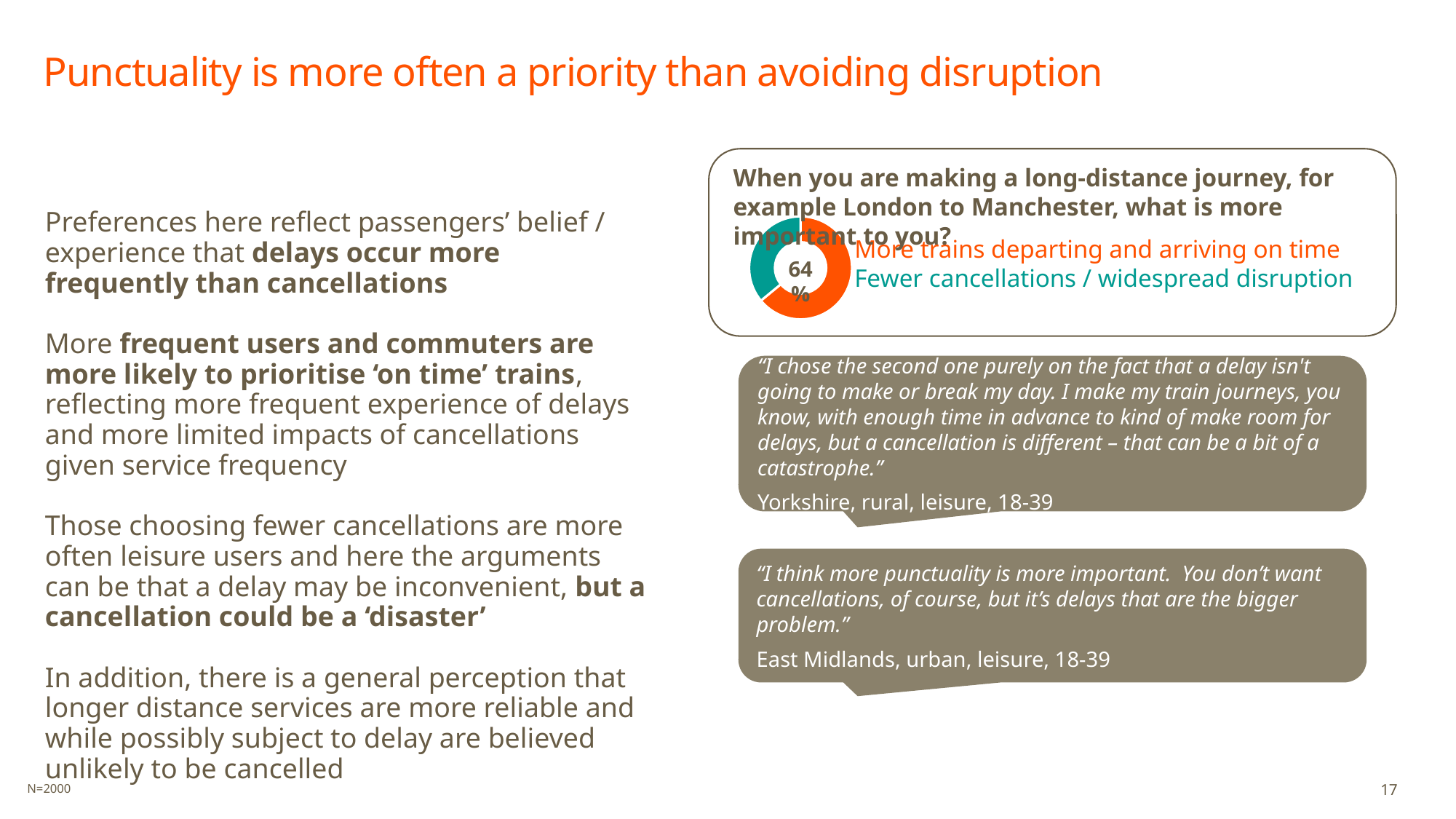
What colour represents 'More trains departing and arriving on time' in the donut chart? Orange Is the share for 'Fewer cancellations / widespread disruption' greater or less than 50%? less Which option takes the smaller share of the donut chart? Fewer cancellations / widespread disruption How many categories does the legend of the donut chart list? 2 What is the sample size (N) noted at the bottom of the slide? N=2000 Is the share for 'More trains departing and arriving on time' larger or smaller than the share for 'Fewer cancellations / widespread disruption'? Larger What share of respondents chose 'More trains departing and arriving on time'? 64% Which option takes the larger share of the donut chart? More trains departing and arriving on time What percentage is printed in the centre of the donut chart? 64% What colour represents 'Fewer cancellations / widespread disruption' in the donut chart? Teal What kind of chart is shown on the slide? Pie chart (donut)